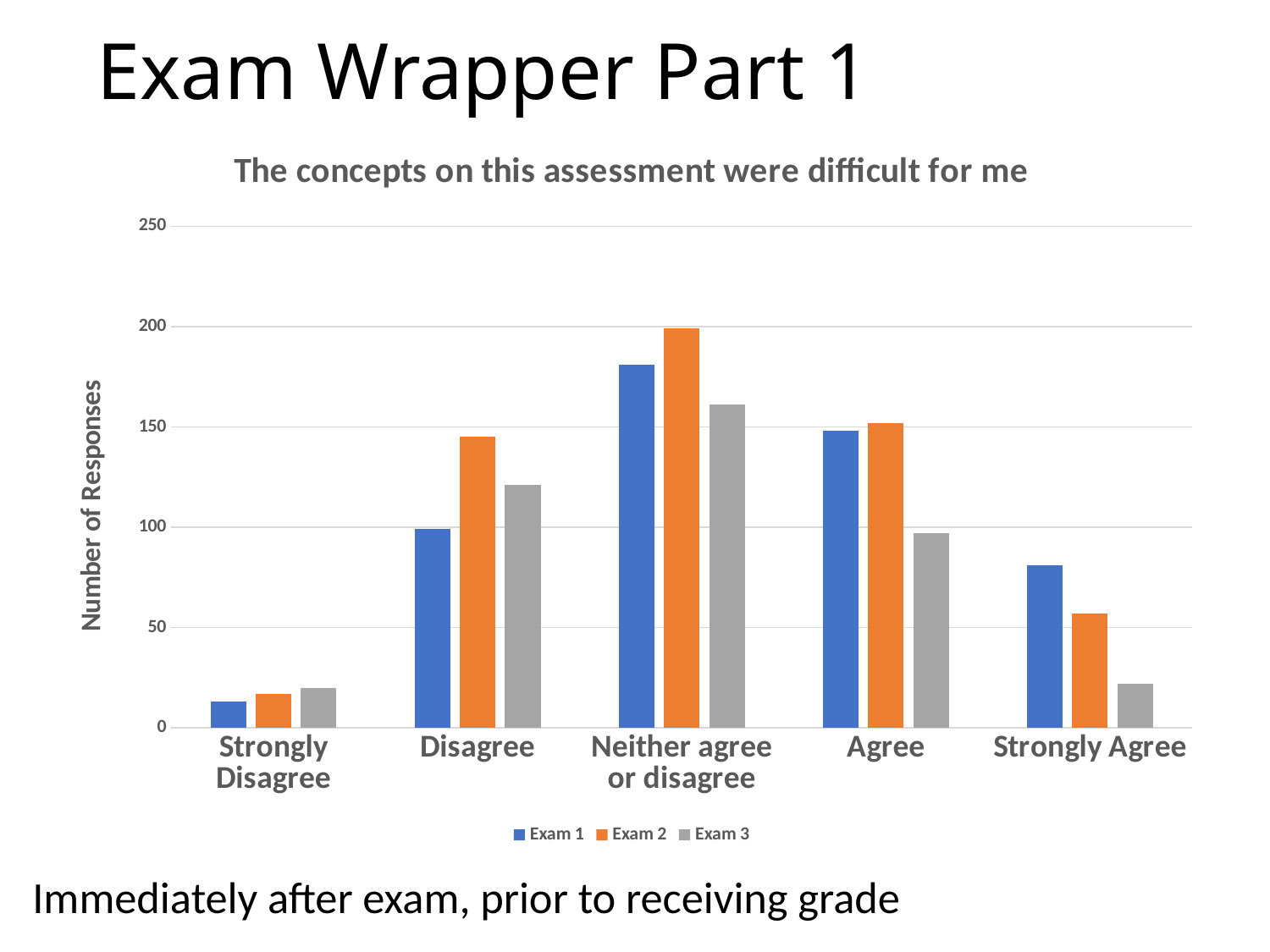
Is the Exam 3 value for Strongly Agree greater or less than 50? less Which response category has the highest Exam 2 value? Neither agree or disagree Which response category has the lowest Exam 3 value? Strongly Disagree What kind of chart is shown on the slide? Bar chart For Strongly Agree, which series has the higher value: Exam 1 or Exam 3? Exam 1 What is the title of the chart? The concepts on this assessment were difficult for me Is the Exam 2 value for Disagree greater or less than 100? greater Is the Exam 1 value for Strongly Agree greater or less than 100? less How many series does the legend list? 3 How many response categories are shown on the x axis? 5 For Disagree, which series has the higher value: Exam 2 or Exam 3? Exam 2